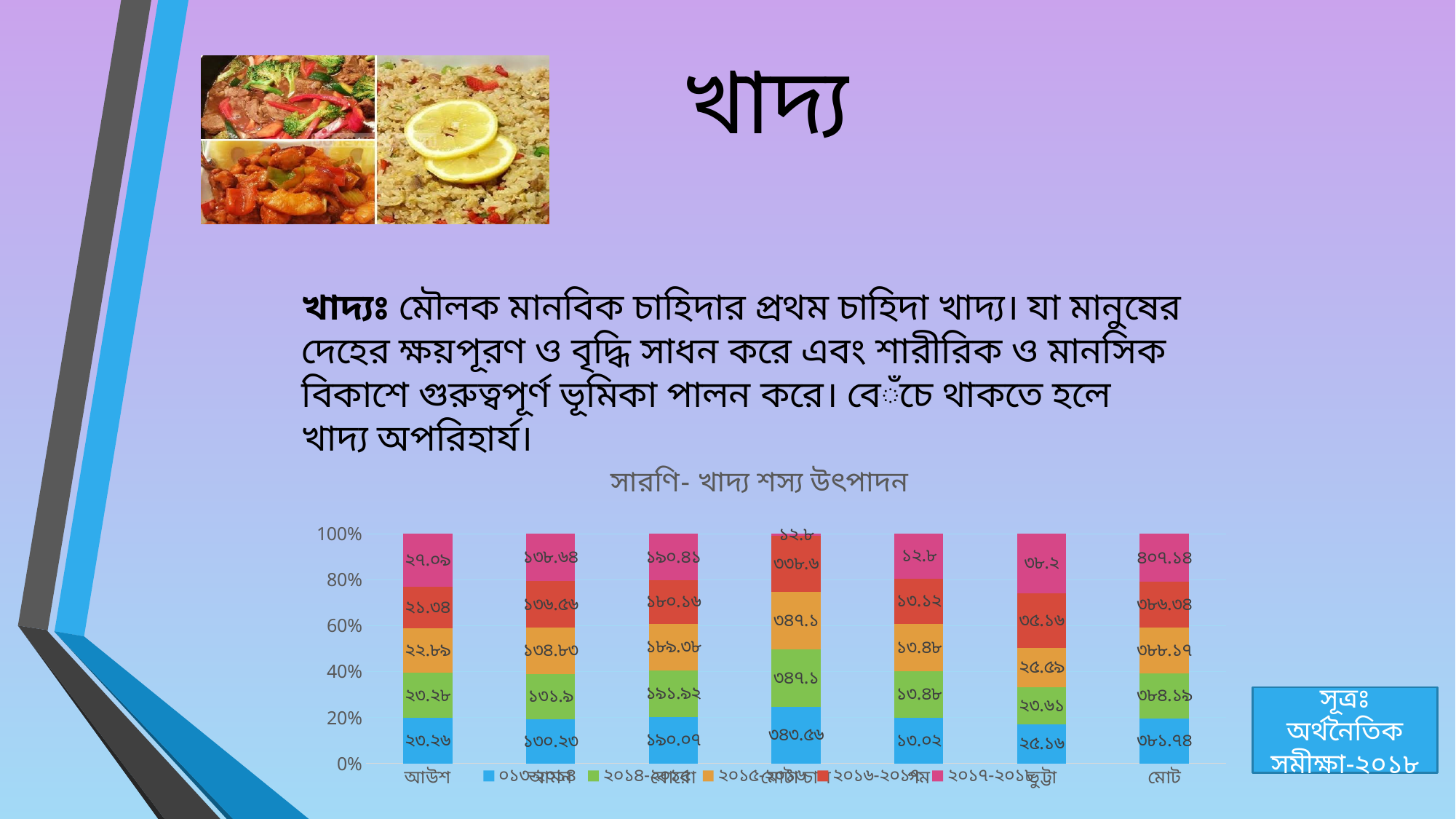
In the আউশ bar, which is larger: the ২০১৭-২০১৮ value or the ২০১৪-২০১৫ value? ২০১৭-২০১৮ Which series has the highest value in the মোট bar? ২০১৭-২০১৮ What is the value of the ২০১৫-২০১৬ (orange) segment of the মোট bar? ৩৮৮.১৭ What is the difference between the ২০১৭-২০১৮ value and the ২০১৩-২০১৪ value in the মোট bar? ২৫.৪ How many series does the chart legend list? 5 Which series has the lowest value in the আউশ bar? ২০১৬-২০১৭ What kind of chart is shown on the slide? bar chart What is the value of the ২০১৬-২০১৭ (red) segment of the আউশ bar? ২১.৩৪ What is the value of the top (২০১৭-২০১৮) segment of the মোট bar? ৪০৭.১৪ What is the value of the bottom (২০১৩-২০১৪) segment of the আউশ bar? ২৩.২৬ What is the title of the chart? সারণি- খাদ্য শস্য উৎপাদন How many categories (bars) are shown along the x axis of the chart? 7